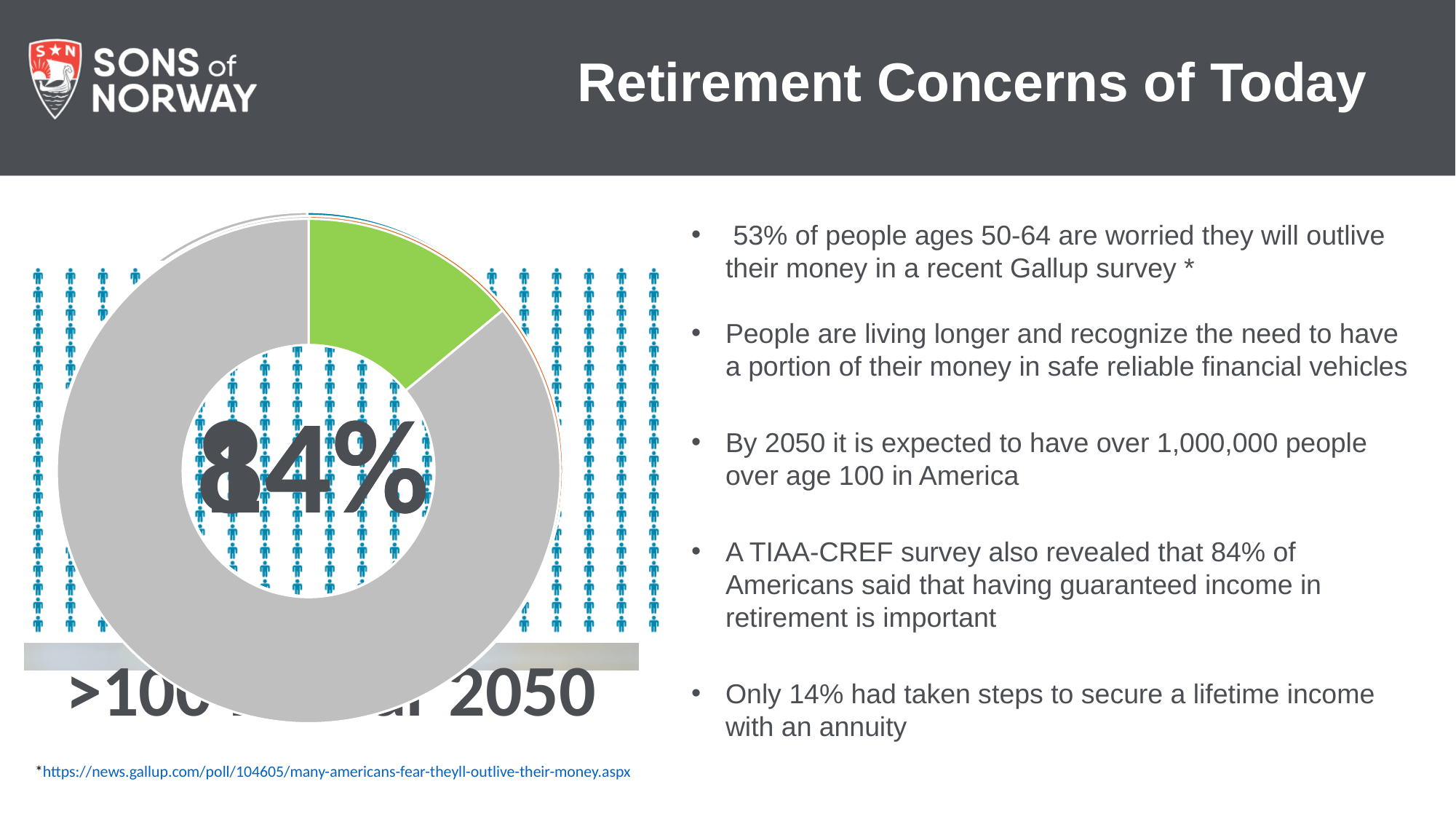
In the donut chart on the left of the slide, what colour is the smaller slice? Green What kind of chart is shown on the left of the slide? Pie (donut) chart In the donut chart on the left of the slide, which slice is larger, the green one or the grey one? The grey one Does the donut chart on the left of the slide show a legend? No How many slices does the donut chart on the left of the slide have? 2